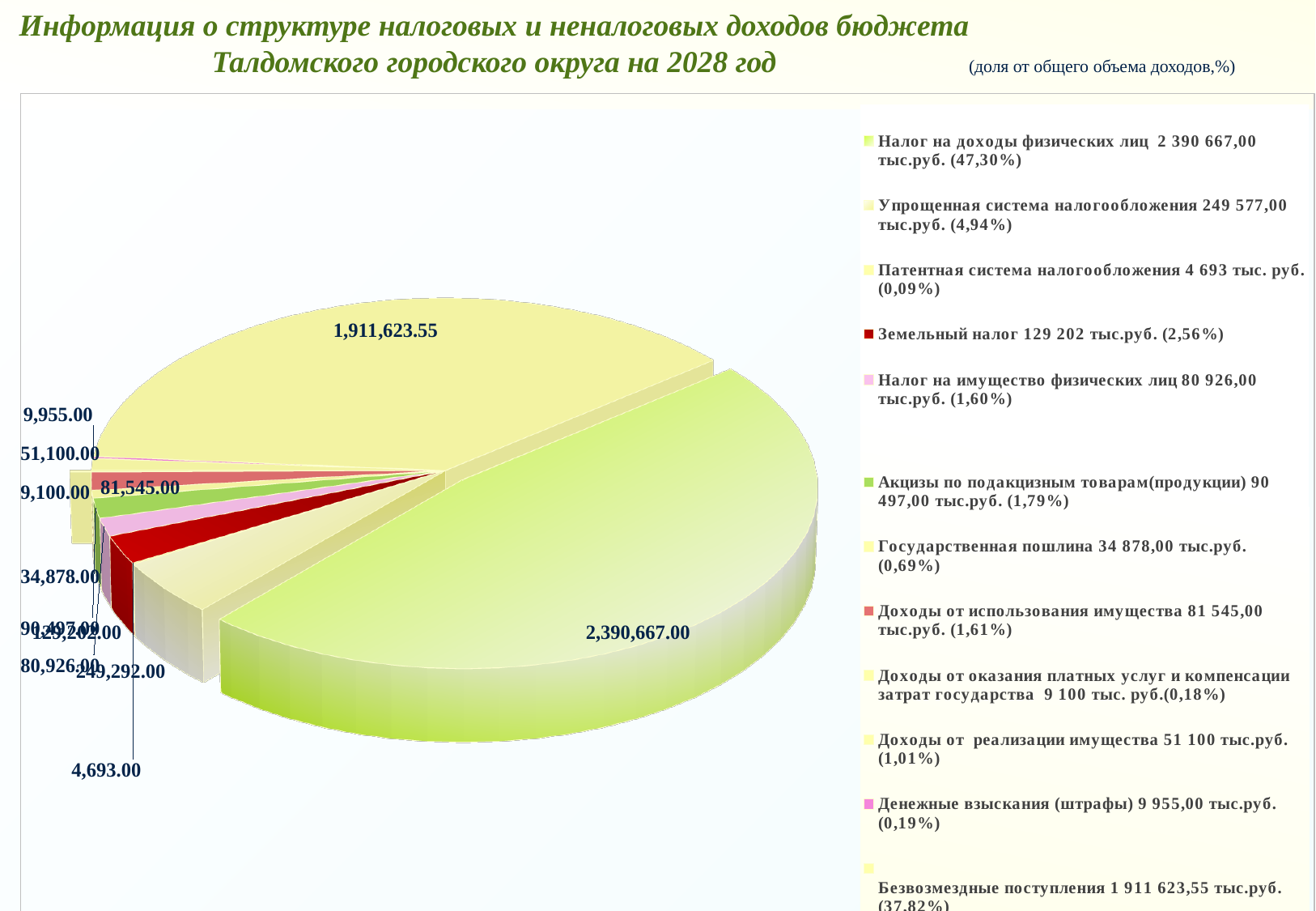
What share of total revenue does Налог на доходы физических лиц represent, according to the legend? 47,30% What is the data label value for the slice Налог на доходы физических лиц? 2,390,667.00 What share of total revenue does Безвозмездные поступления represent, according to the legend? 37,82% Which category has the largest slice of the pie? Налог на доходы физических лиц What is the difference between the data label values for Налог на доходы физических лиц and Безвозмездные поступления? 479,043.45 What is the data label value for the slice Безвозмездные поступления? 1,911,623.55 What is the data label value for the slice Доходы от использования имущества? 81,545.00 Which is larger: the slice for Доходы от реализации имущества or the slice for Государственная пошлина? Доходы от реализации имущества What is the data label value for the slice Государственная пошлина? 34,878.00 What kind of chart is shown on the slide? pie chart How many entries does the legend list? 12 Which category has the smallest slice of the pie? Патентная система налогообложения